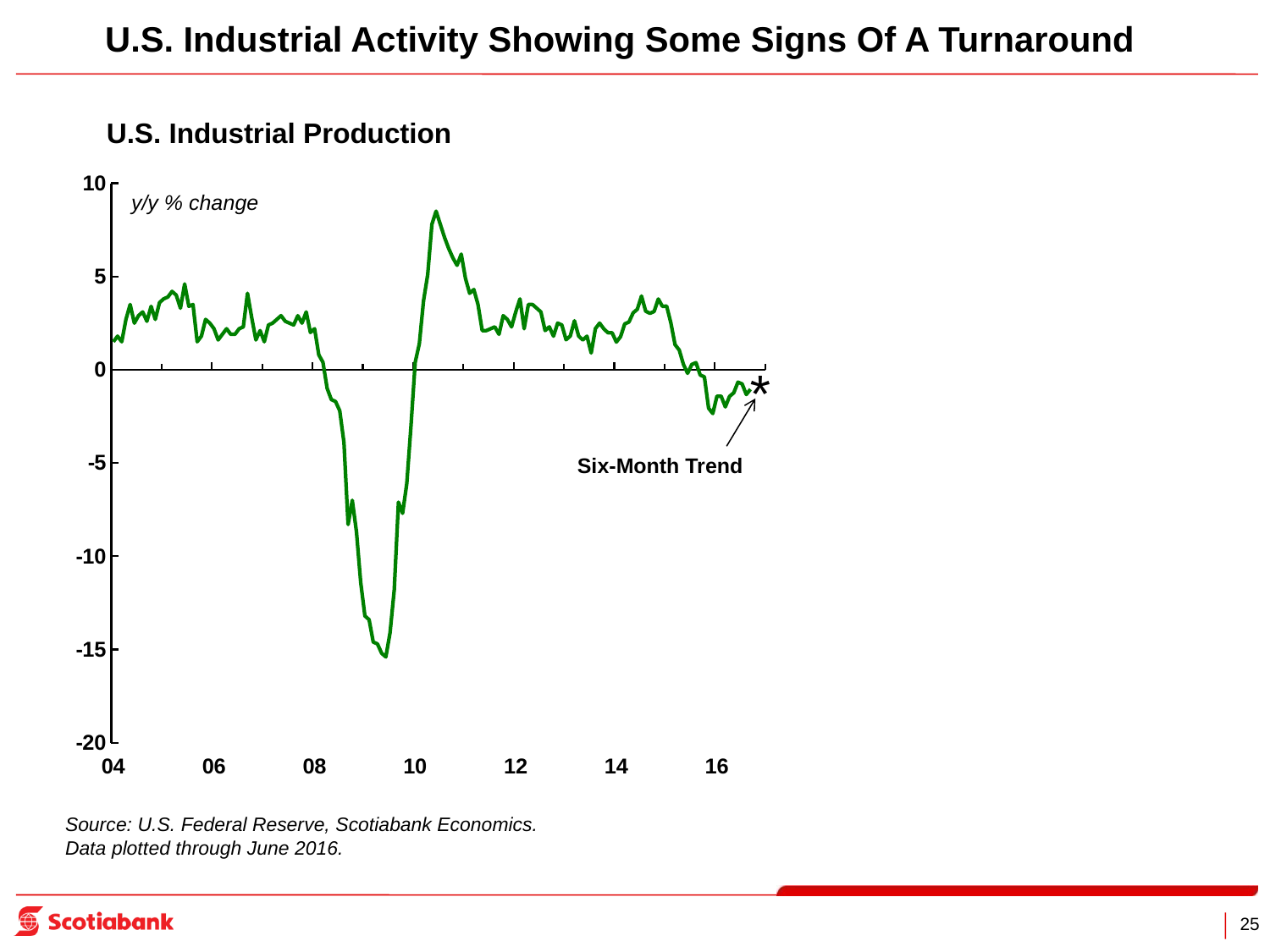
Does the line rise or fall between 2009 and 2010? rise Is the lowest value of the line, reached around 2009, greater or less than -10? less Around which year labelled on the x axis does the line reach its lowest point? 10 What unit is the y axis of the chart measured in? y/y % change What does the arrow annotation near the end of the line point to? Six-Month Trend Is the value of the line at the start of 2004 greater or less than 0? greater How many year labels are shown on the x axis? 7 What is the title of the chart? U.S. Industrial Production Is the value of the line at the end of the series in 2016 greater or less than 0? less Does the line rise or fall between 2014 and 2016? fall What kind of chart is shown on the slide? line chart